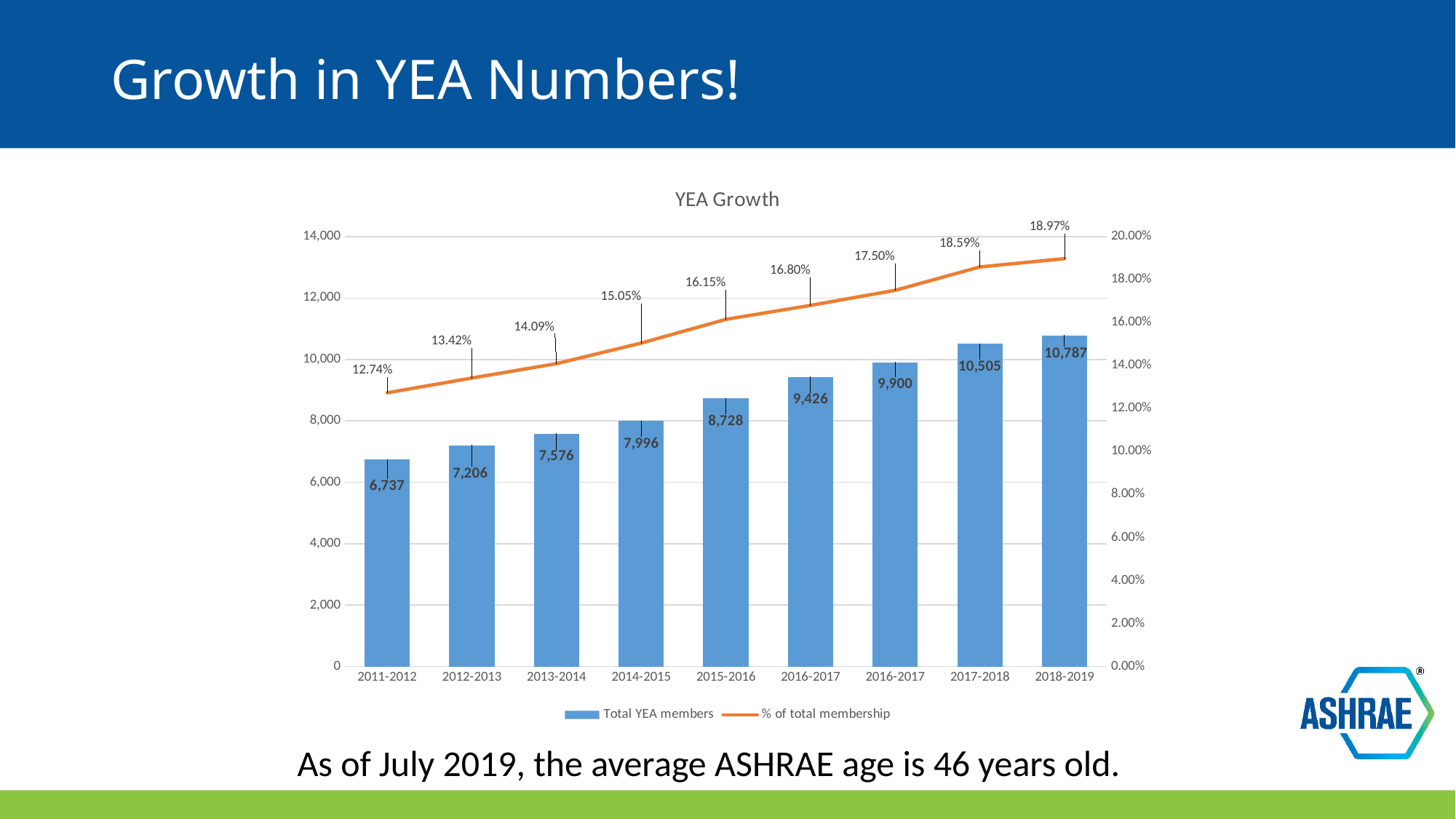
Which period has the highest Total YEA members? 2018-2019 What is the value of Total YEA members for 2018-2019? 10,787 What is the value of Total YEA members for 2011-2012? 6,737 What is the title of the chart? YEA Growth Which period has the lowest % of total membership? 2011-2012 What is the % of total membership for 2014-2015? 15.05% How many periods are shown on the x axis? 9 What is the % of total membership for 2017-2018? 18.59% Which is larger, Total YEA members in 2013-2014 or in 2015-2016? 2015-2016 What is the difference in Total YEA members between 2018-2019 and 2017-2018? 282 How many series does the legend list? 2 Does the % of total membership rise or fall from 2011-2012 to 2018-2019? rise